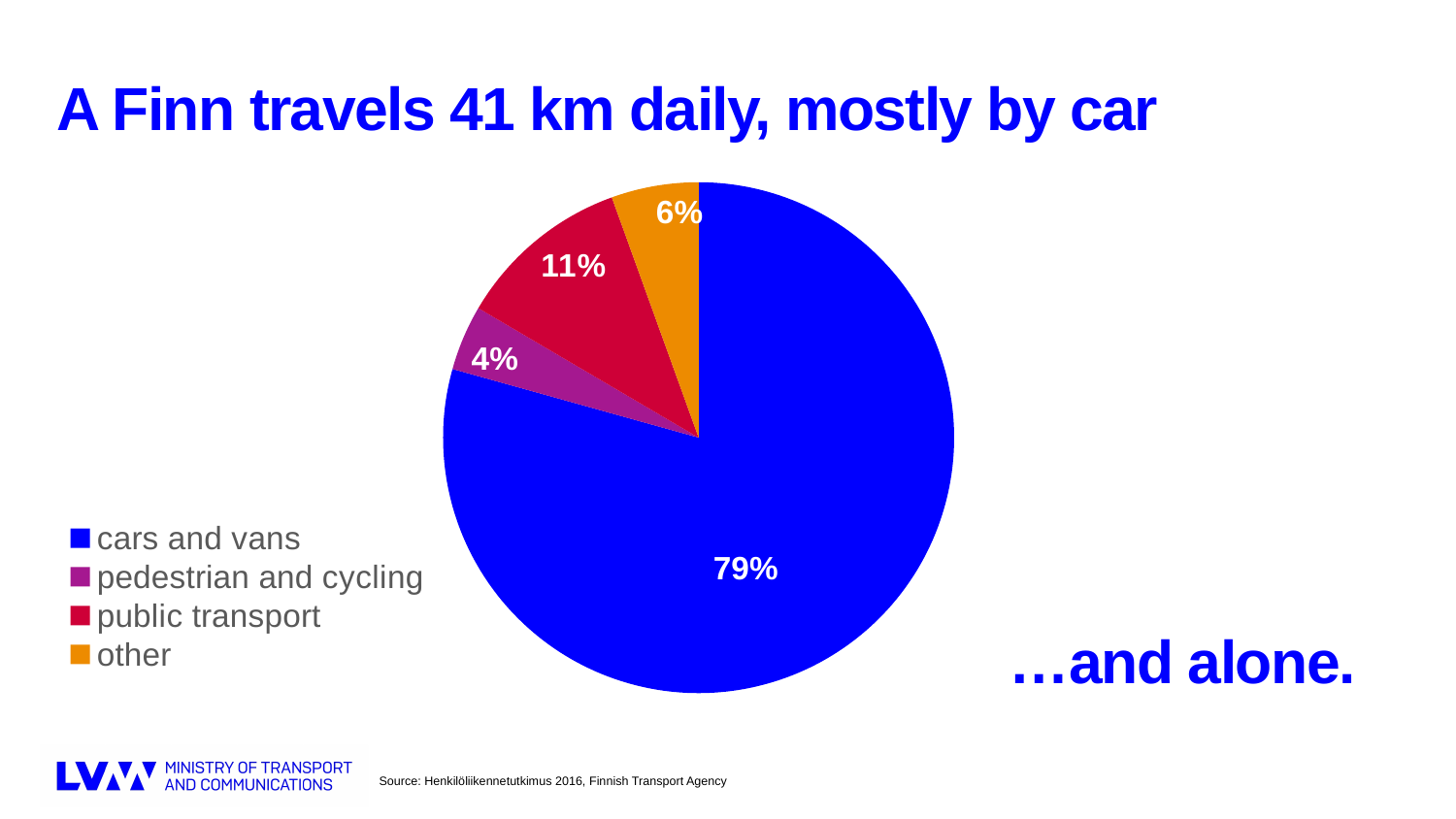
How many categories does the pie chart have? 4 Which category has the smallest slice? pedestrian and cycling What kind of chart is shown on the slide? pie chart What is the title of the slide? A Finn travels 41 km daily, mostly by car What is the value for public transport? 11% What is the value for other? 6% What is the difference between the cars and vans share and the public transport share? 68% What share of the pie does cars and vans account for? 79% What colour is the slice for public transport? red Which is larger, public transport or other? public transport Which category has the largest slice? cars and vans What is the value for pedestrian and cycling? 4%